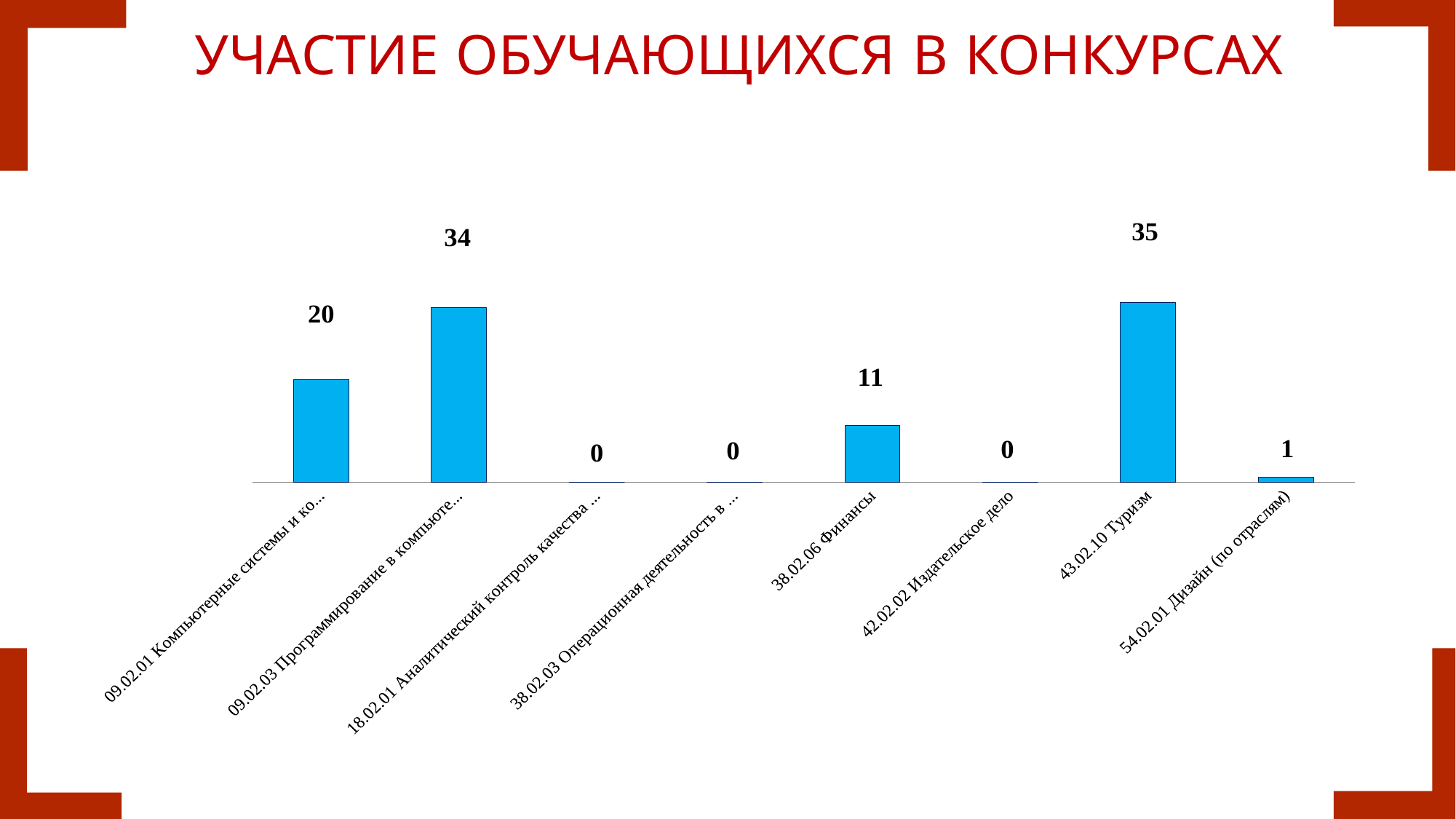
Which is larger, the value for 09.02.01 Компьютерные системы и ко... or the value for 38.02.06 Финансы? 09.02.01 Компьютерные системы и ко... What type of chart is shown on the slide? Bar chart What is the difference between the values for 43.02.10 Туризм and 09.02.03 Программирование в компьюте...? 1 What is the value for the first category, 09.02.01 Компьютерные системы и ко...? 20 What is the value for 54.02.01 Дизайн (по отраслям)? 1 What is the value for 38.02.06 Финансы? 11 How many categories have a value of 0? 3 Which category has the highest value? 43.02.10 Туризм What is the value for 42.02.02 Издательское дело? 0 How many categories are shown on the x axis? 8 What is the value for 43.02.10 Туризм? 35 What is the difference between the values for 09.02.03 Программирование в компьюте... and 38.02.06 Финансы? 23